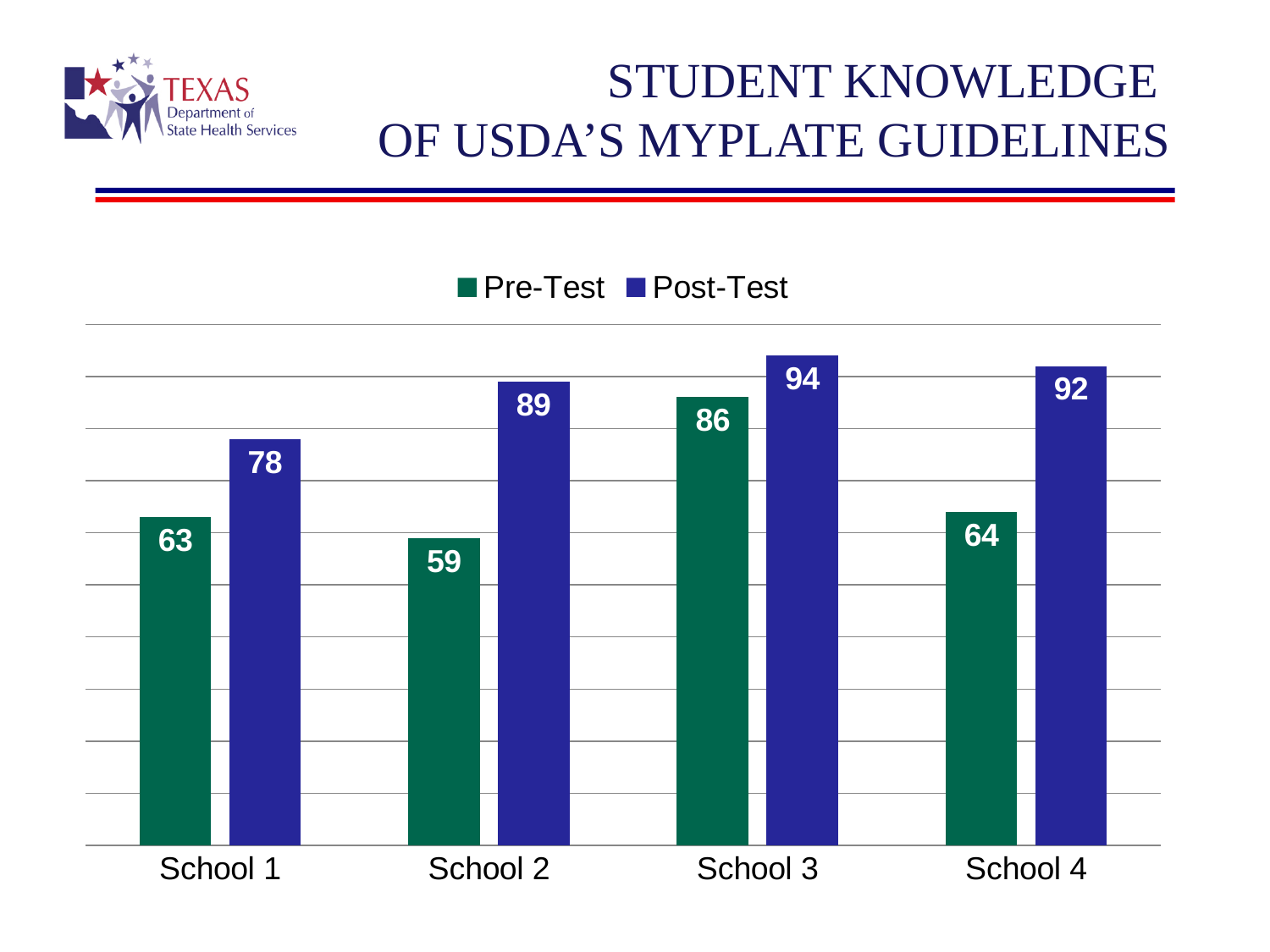
Which school has the lowest Pre-Test value? School 2 How many series does the legend list? 2 What kind of chart is shown on the slide? Bar chart What is the difference between the Post-Test and Pre-Test values for School 4? 28 Which is larger, the Pre-Test value for School 3 or the Post-Test value for School 1? Pre-Test value for School 3 Which colour represents the Post-Test series? Blue What is the Post-Test value for School 1? 78 How many schools are shown on the x axis? 4 What is the difference between the Post-Test values for School 2 and School 1? 11 What is the Post-Test value for School 3? 94 What is the Pre-Test value for School 2? 59 Which school has the highest Post-Test value? School 3